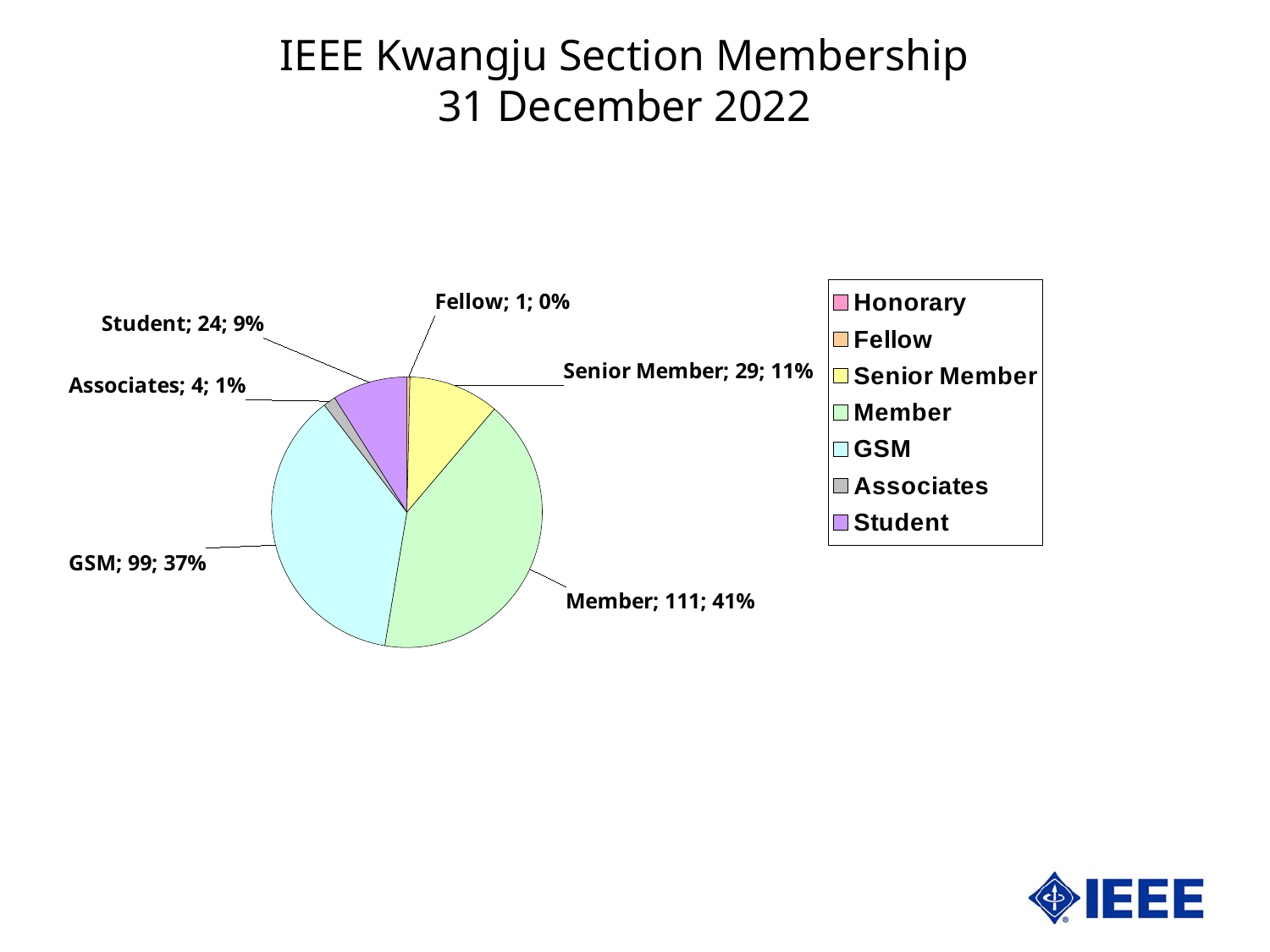
How many Senior Members are shown? 29 How many entries does the legend list? 7 What is the title of the chart? IEEE Kwangju Section Membership 31 December 2022 Which is larger, the Student count or the Senior Member count? Senior Member Which labelled category has the smallest value? Fellow What is the value shown for Associates? 4 Which category has the largest slice of the pie? Member What kind of chart is shown on the slide? pie chart What is the difference between the Member count and the GSM count? 12 How many members are in the Member category? 111 What share of the pie does GSM represent? 37% What percentage share is shown for Student? 9%